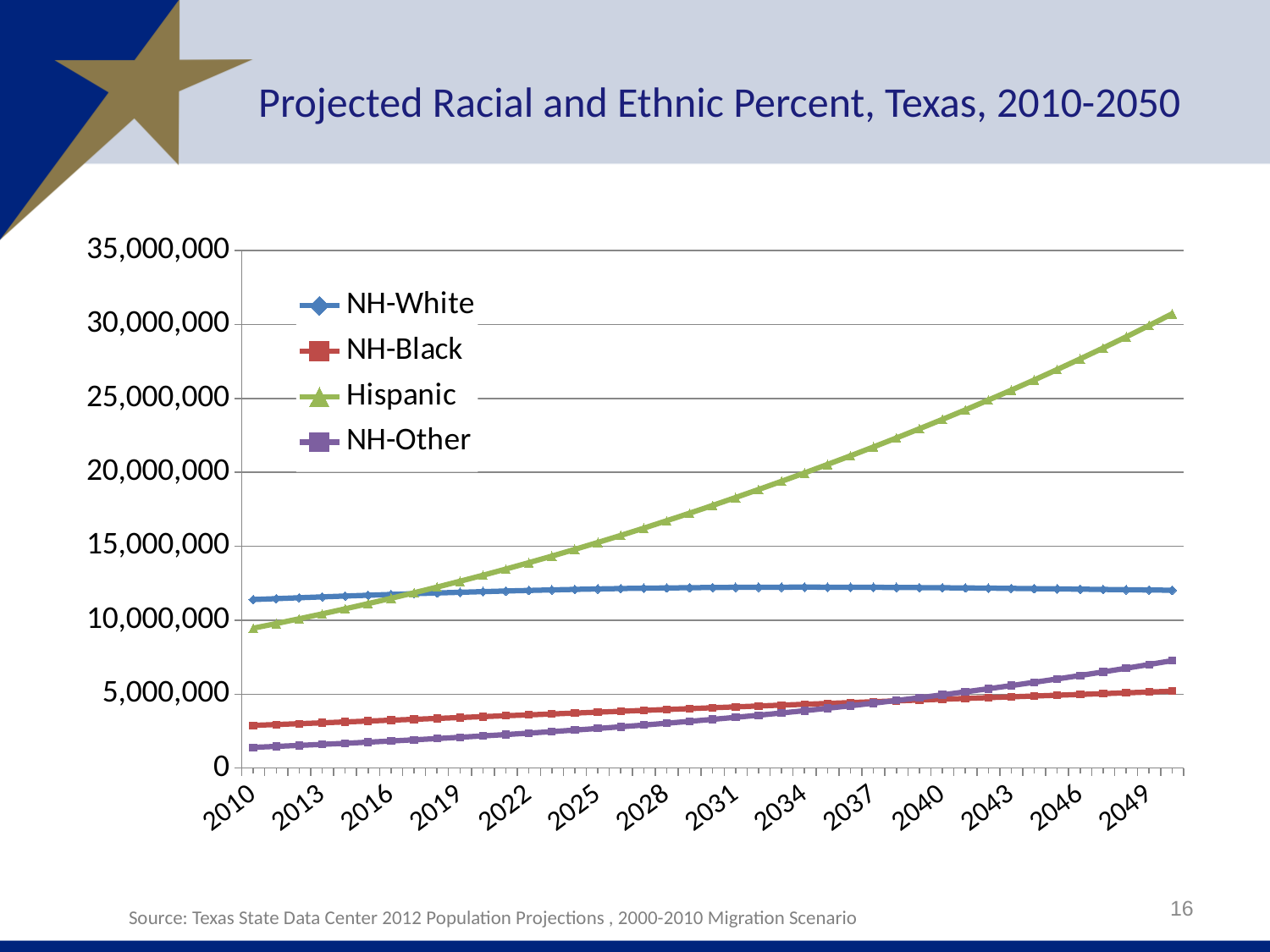
How many series does the legend list? 4 Is the Hispanic value in 2010 greater or less than 10,000,000? less Which series is plotted with green triangle markers? Hispanic At the right end of the chart (2050), which is larger, NH-Other or NH-Black? NH-Other What kind of chart is shown on the slide? line chart Does the NH-Other series rise or fall from 2010 to 2050? rise Is the Hispanic value in 2040 greater or less than 20,000,000? greater Which series has the lowest value in 2010? NH-Other What is the title of the chart? Projected Racial and Ethnic Percent, Texas, 2010-2050 Which series has the highest value at the right end of the chart (2050)? Hispanic In 2010, which is larger, NH-White or Hispanic? NH-White Does the Hispanic series rise or fall from 2010 to 2050? rise